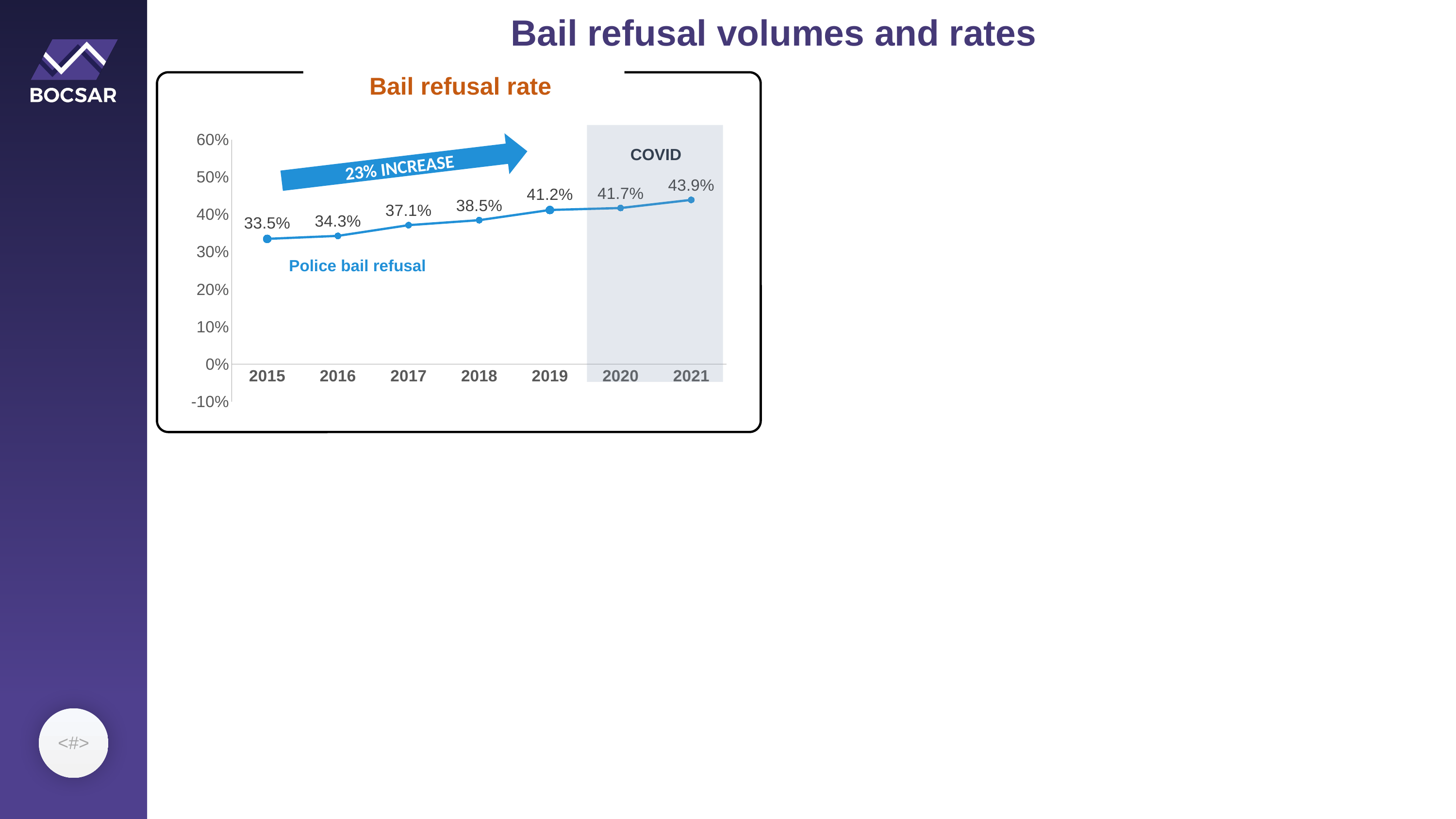
What kind of chart is shown on the slide? Line chart Which years are shaded as the COVID period on the chart? 2020 and 2021 What is the police bail refusal rate in 2019? 41.2% What is the difference between the police bail refusal rate in 2021 and in 2015? 10.4% How many years are plotted on the chart? 7 Which year has the lowest police bail refusal rate? 2015 What is the title of the chart? Bail refusal rate Which year has the highest police bail refusal rate? 2021 Does the police bail refusal rate rise or fall from 2015 to 2021? Rises What is the police bail refusal rate in 2021? 43.9% Which year has a higher police bail refusal rate, 2017 or 2018? 2018 What is the police bail refusal rate in 2015? 33.5%